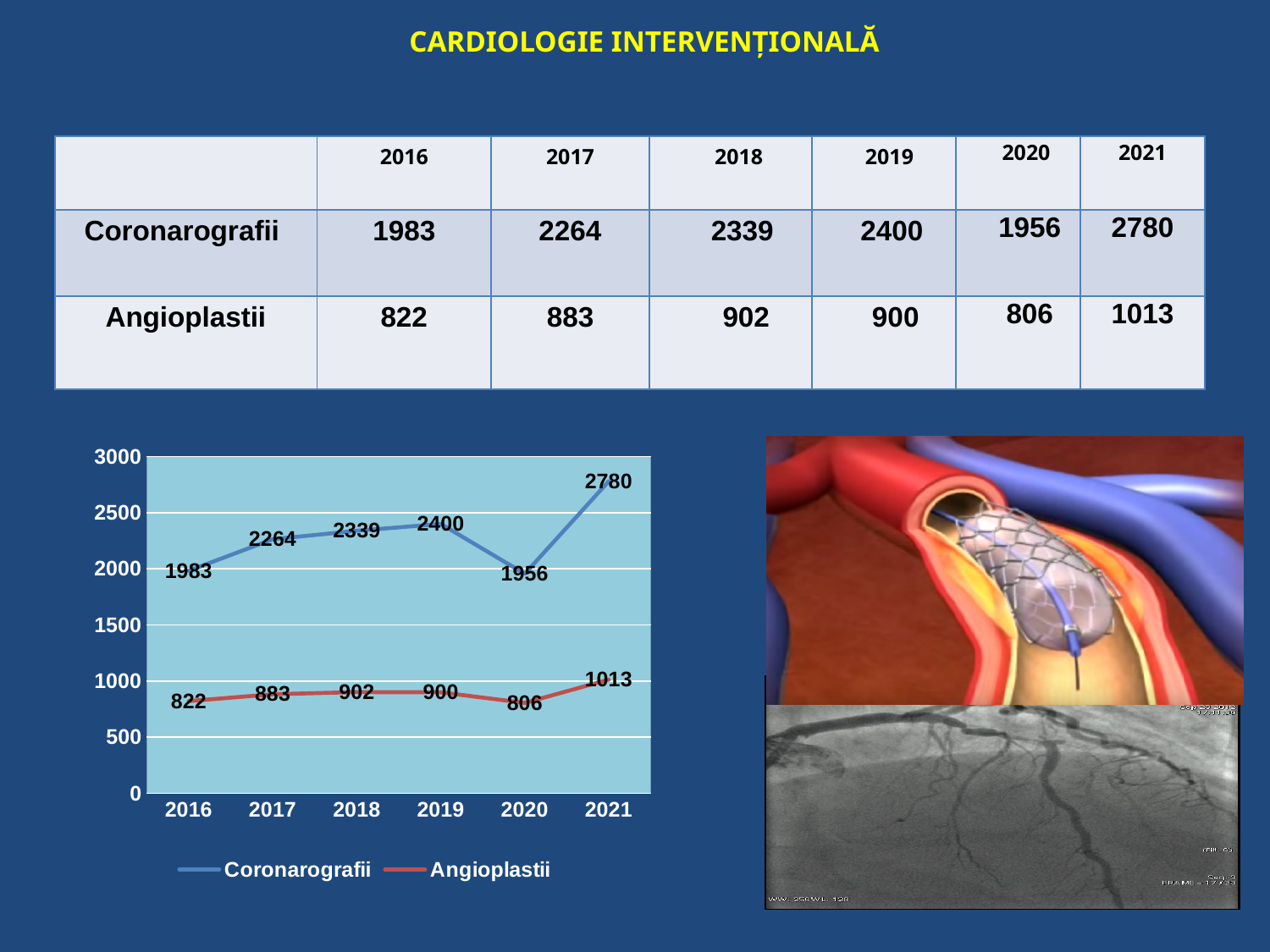
Does the Coronarografii series rise or fall from 2019 to 2020? fall What is the difference between the Coronarografii values for 2021 and 2020? 824 What is the value for Angioplastii in 2020? 806 What type of chart is shown on the slide? line chart What is the value for Coronarografii in 2021? 2780 In which year is the Angioplastii value lowest? 2020 What colour is the Angioplastii line in the chart? red How many years are shown on the x axis of the chart? 6 What is the difference between the Angioplastii values for 2021 and 2016? 191 How many series does the legend list? 2 Which is larger: the Angioplastii value for 2018 or for 2019? 2018 In which year is the Coronarografii value highest? 2021